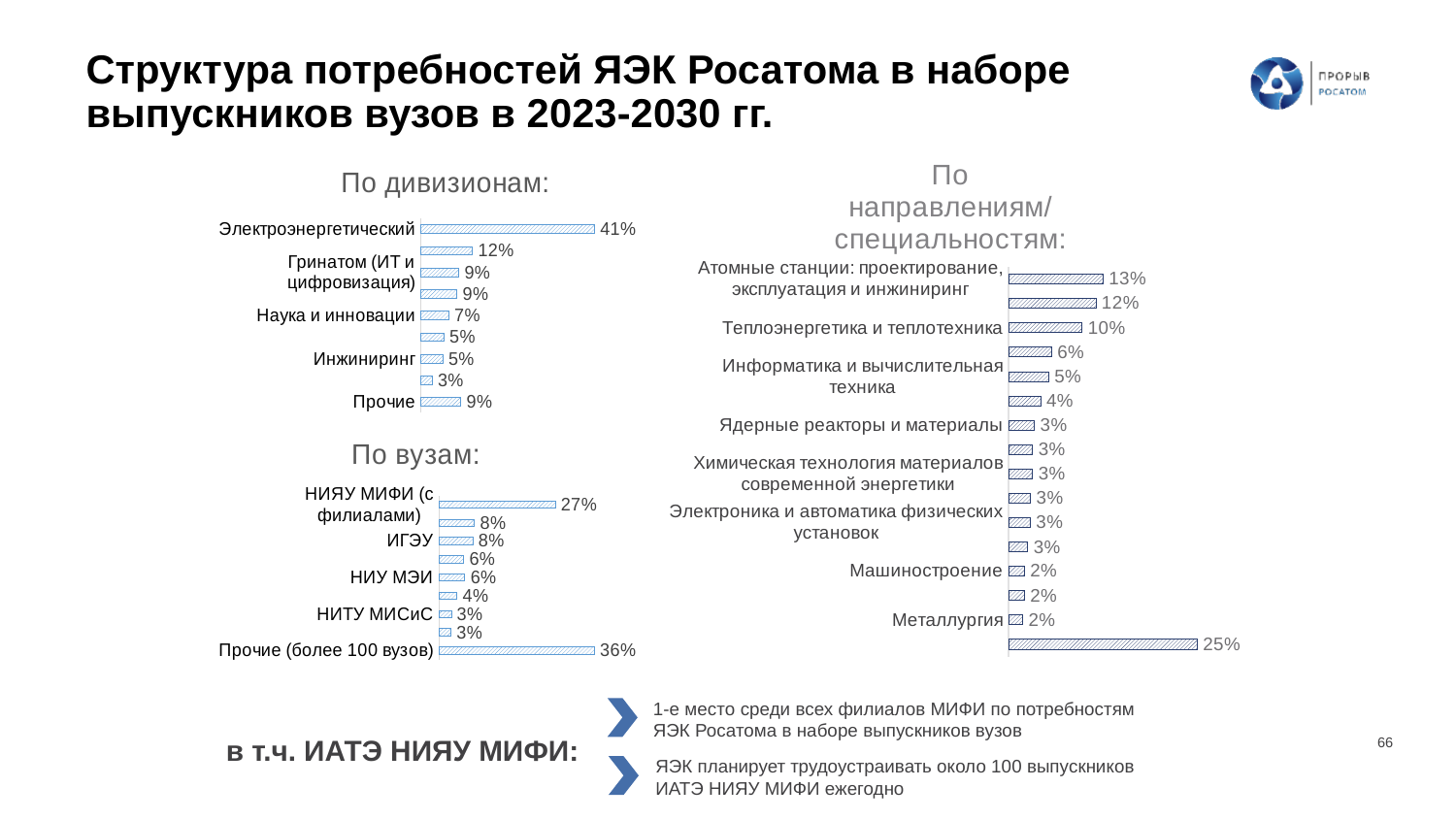
In the 'По направлениям/специальностям' chart, what is the value for Машиностроение? 2% In the 'По дивизионам' chart, which category has the highest value? Электроэнергетический In the 'По вузам' chart, what is the value for Прочие (более 100 вузов)? 36% In the 'По направлениям/специальностям' chart, what is the value for Теплоэнергетика и теплотехника? 10% In the 'По вузам' chart, how many bars are plotted? 9 In the 'По дивизионам' chart, what is the difference between Электроэнергетический and Инжиниринг? 36% In the 'По дивизионам' chart, what is the value for Наука и инновации? 7% What type of chart is the 'По вузам' chart? Bar chart In the 'По вузам' chart, which is larger: ИГЭУ or НИТУ МИСиС? ИГЭУ In the 'По направлениям/специальностям' chart, what is the difference between Атомные станции: проектирование, эксплуатация и инжиниринг and Ядерные реакторы и материалы? 10% In the 'По вузам' chart, what is the value for НИЯУ МИФИ (с филиалами)? 27% In the 'По дивизионам' chart, what is the value for Электроэнергетический? 41%